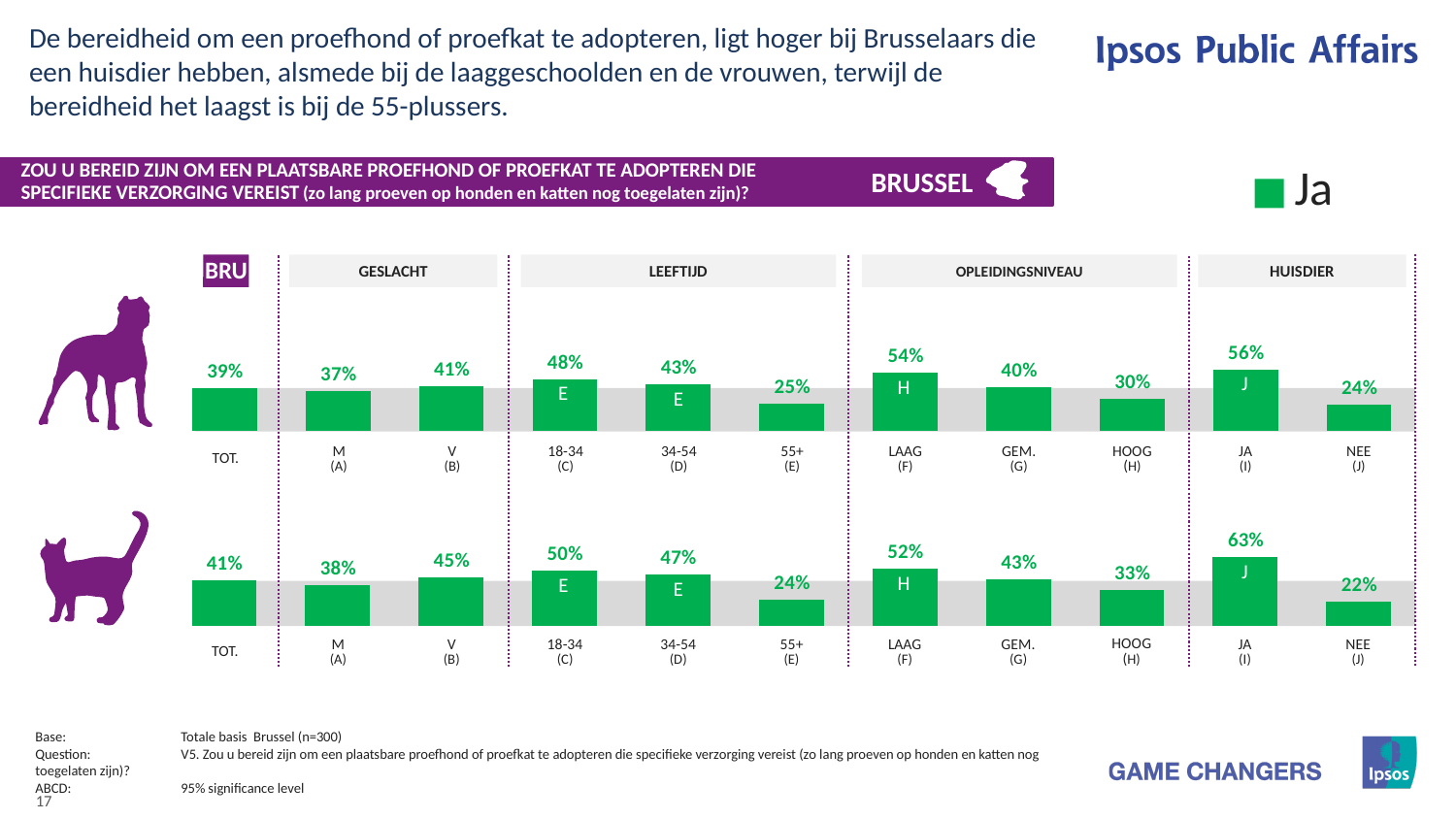
In the top (dog) chart, what is the value for TOT.? 39% How many categories are plotted in the bottom (cat) chart? 11 In the top (dog) chart, what is the value for HOOG (H)? 30% In the bottom (cat) chart, what is the difference between the values for JA (I) and NEE (J)? 41% In the bottom (cat) chart, which is larger, the value for 18-34 (C) or the value for 34-54 (D)? 18-34 (C) In the top (dog) chart, which is larger, the value for M (A) or the value for V (B)? V (B) In the top (dog) chart, what is the difference between the values for LAAG (F) and HOOG (H)? 24% In the top (dog) chart, which category has the lowest value? NEE (J) In the top (dog) chart, do the values rise or fall across the age groups from 18-34 to 55+? Fall In the bottom (cat) chart, what is the value for 55+ (E)? 24% What kind of chart is used on this slide? Bar chart In the bottom (cat) chart, which category has the highest value? JA (I)